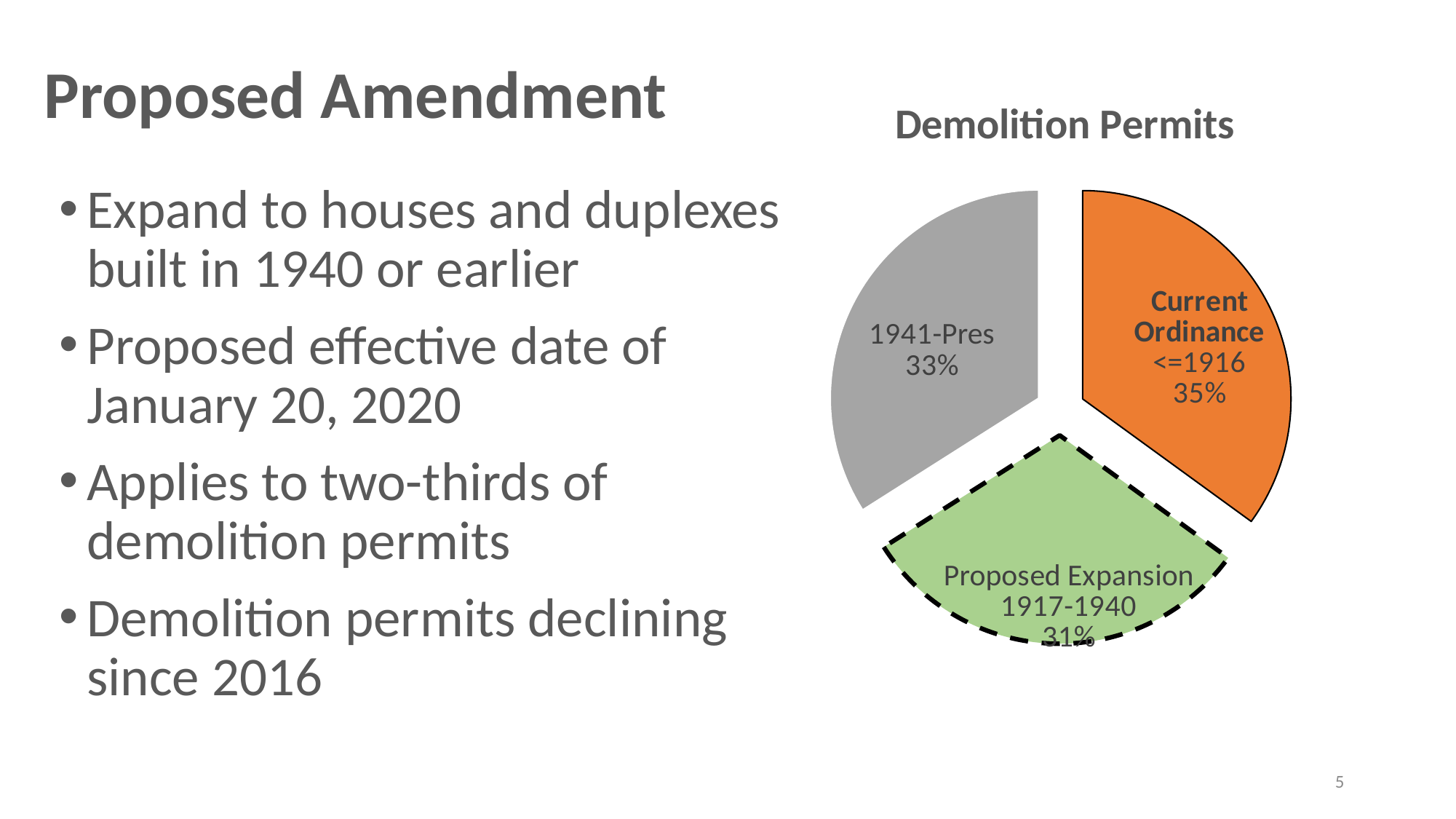
How many slices does the pie chart have? 3 Which is larger, the 1941-Pres slice or the Proposed Expansion 1917-1940 slice? 1941-Pres What kind of chart is shown on the slide? pie chart What share of demolition permits is for the Current Ordinance (<=1916) slice? 35% What share of demolition permits is for the 1941-Pres slice? 33% What is the difference in percentage points between the Current Ordinance slice and the Proposed Expansion slice? 4 What share of demolition permits is for the Proposed Expansion (1917-1940) slice? 31% What colour is the Proposed Expansion slice? green Which slice of the pie chart is the smallest? Proposed Expansion 1917-1940 Which slice of the pie chart is the largest? Current Ordinance <=1916 What is the title of the chart? Demolition Permits What is the combined share of the Current Ordinance and Proposed Expansion slices? 66%